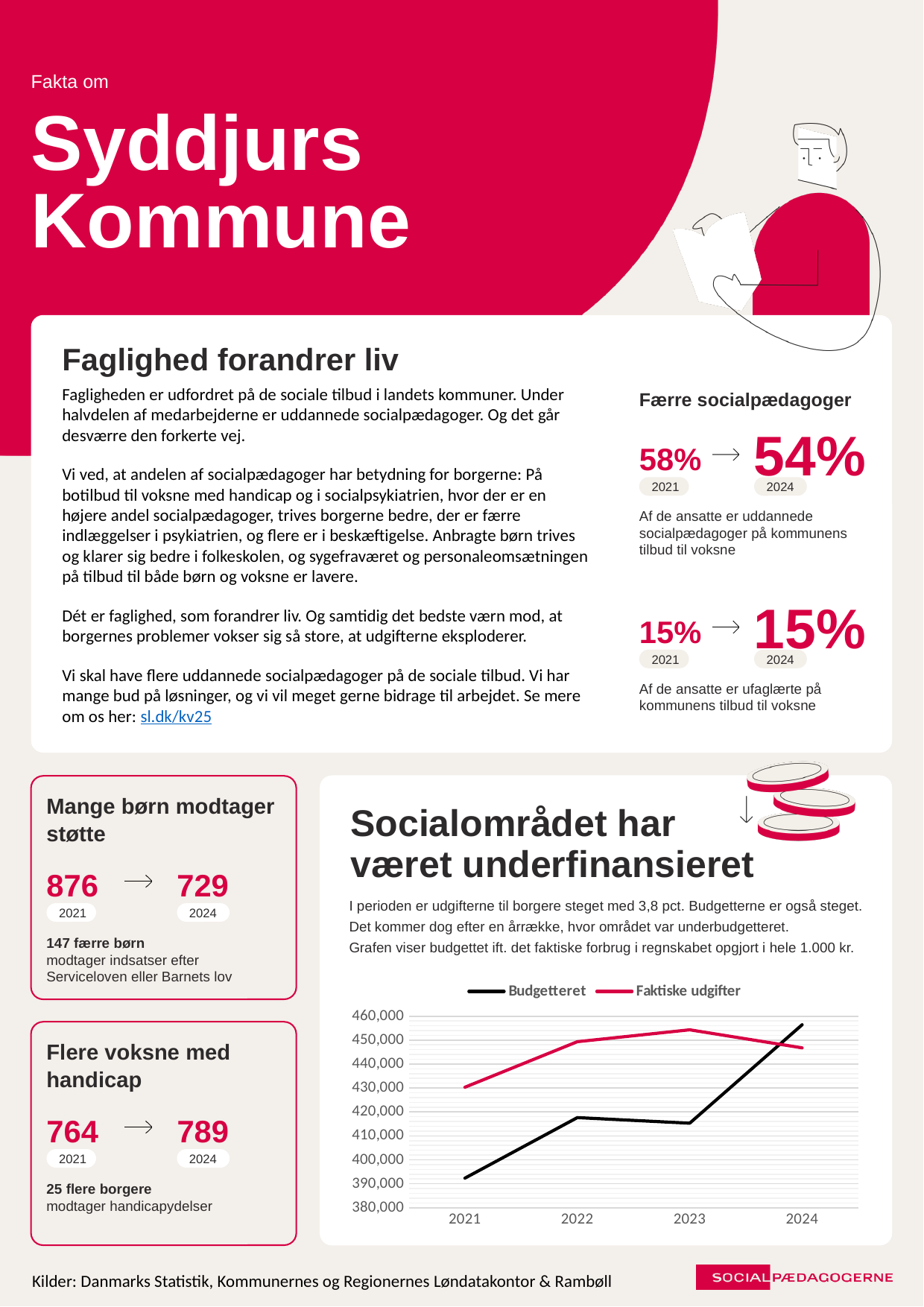
In the line chart, does the Budgetteret series rise or fall from 2021 to 2024 overall? rise What kind of chart is shown in the 'Socialområdet har været underfinansieret' section? line chart In the line chart, which series has the larger value in 2021, Budgetteret or Faktiske udgifter? Faktiske udgifter In the line chart, which year has the highest value for Faktiske udgifter? 2023 In the line chart, is the Budgetteret value for 2024 greater or less than 450,000? greater How many years are plotted on the x axis of the line chart? 4 How many series does the legend of the line chart list? 2 In the line chart, which year has the lowest value for Budgetteret? 2021 In the line chart, is the Budgetteret value for 2021 greater or less than 400,000? less In the line chart, which year has the highest value for Budgetteret? 2024 In the line chart, is the Faktiske udgifter value for 2021 greater or less than 420,000? greater Which series in the line chart is drawn in red? Faktiske udgifter